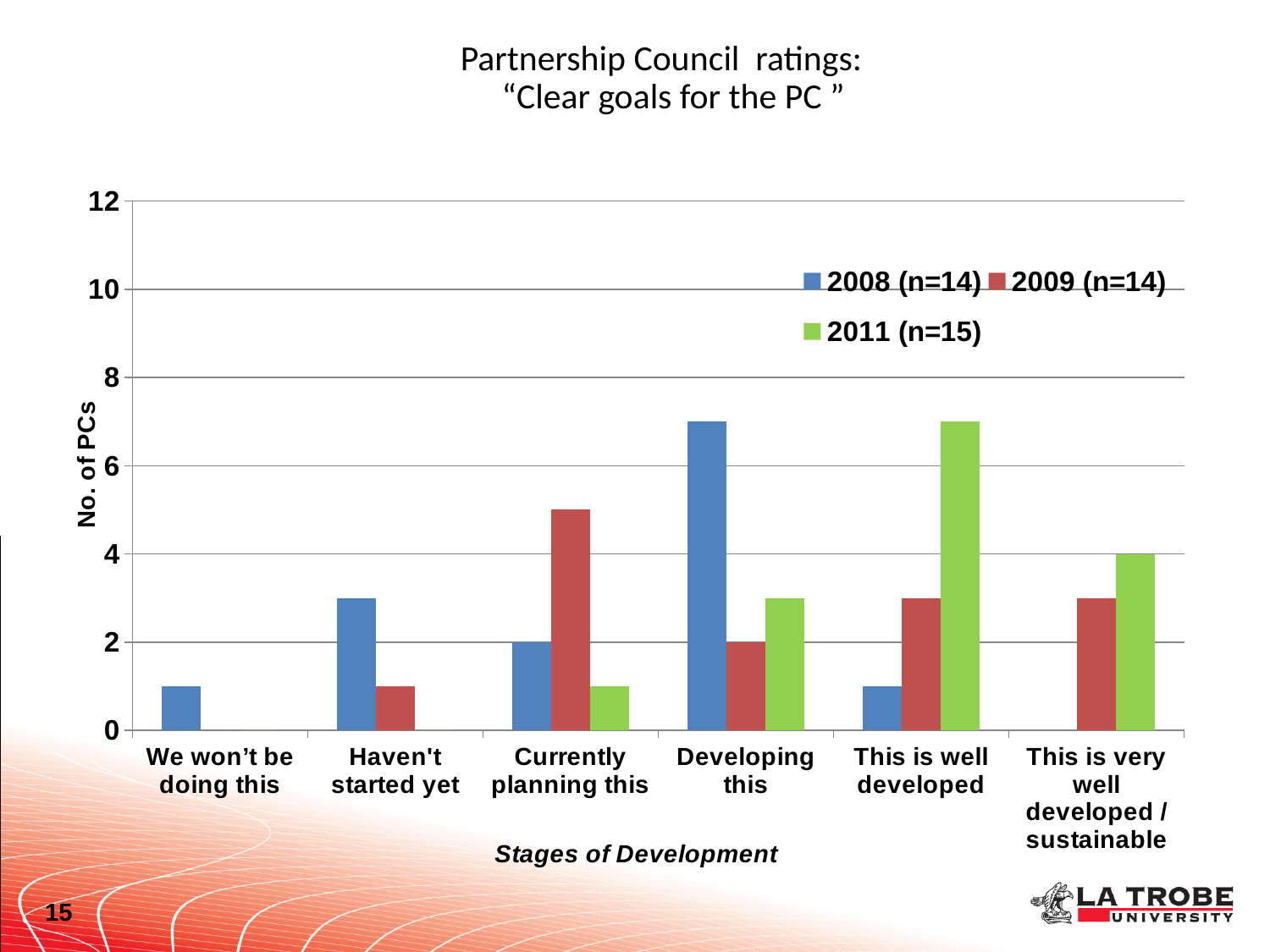
How many stages of development are shown on the x axis? 6 What is the value for 2009 (n=14) in the "Developing this" category? 2 What is the value for 2011 (n=15) in the "This is very well developed / sustainable" category? 4 Which stage of development has the highest value for the 2011 (n=15) series? This is well developed Which stage of development has the highest value for the 2009 (n=14) series? Currently planning this What type of chart is shown on the slide? bar chart In the "This is well developed" category, which series is larger: 2008 (n=14) or 2011 (n=15)? 2011 (n=15) Is the value for 2009 (n=14) in the "Currently planning this" category greater or less than 4? greater How many series does the legend list? 3 Which stage of development has the highest value for the 2008 (n=14) series? Developing this What is the title of the vertical axis? No. of PCs What is the value for 2008 (n=14) in the "Currently planning this" category? 2